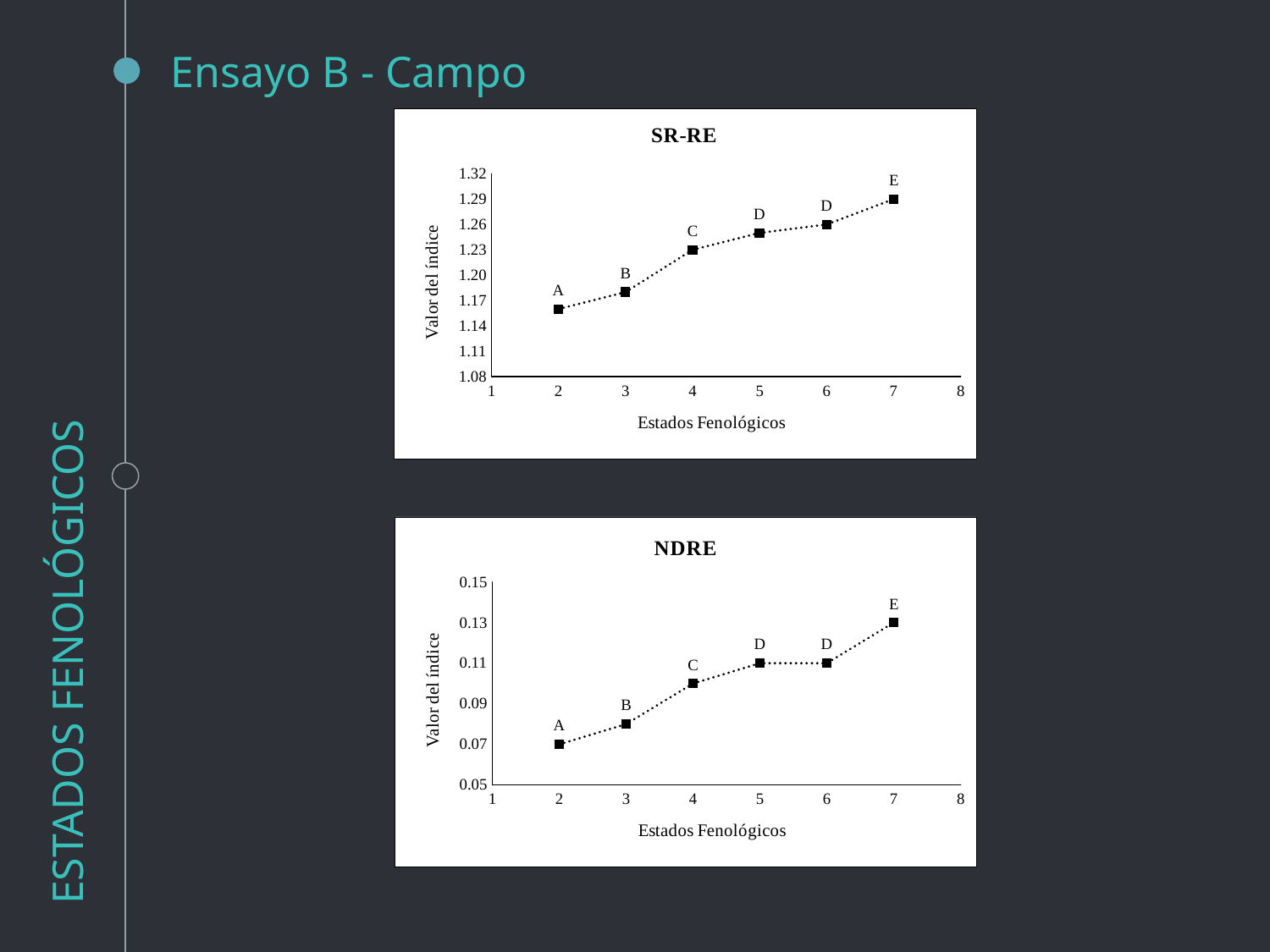
In the NDRE chart, which is larger, the value at phenological stage 4 or at stage 7? stage 7 What is the title of the lower chart on the slide? NDRE In the SR-RE chart, how many data points are plotted? 6 In the SR-RE chart, at which phenological stage is the index value lowest? 2 In the NDRE chart, is the value at phenological stage 2 greater or less than 0.09? less In the NDRE chart, at which phenological stage is the index value highest? 7 In the NDRE chart, how many data points are plotted? 6 In the SR-RE chart, what kind of chart is shown? line chart In the SR-RE chart, is the value at phenological stage 7 greater or less than 1.26? greater In the SR-RE chart, do the index values rise or fall as the phenological stage increases? rise In the SR-RE chart, at which phenological stage is the index value highest? 7